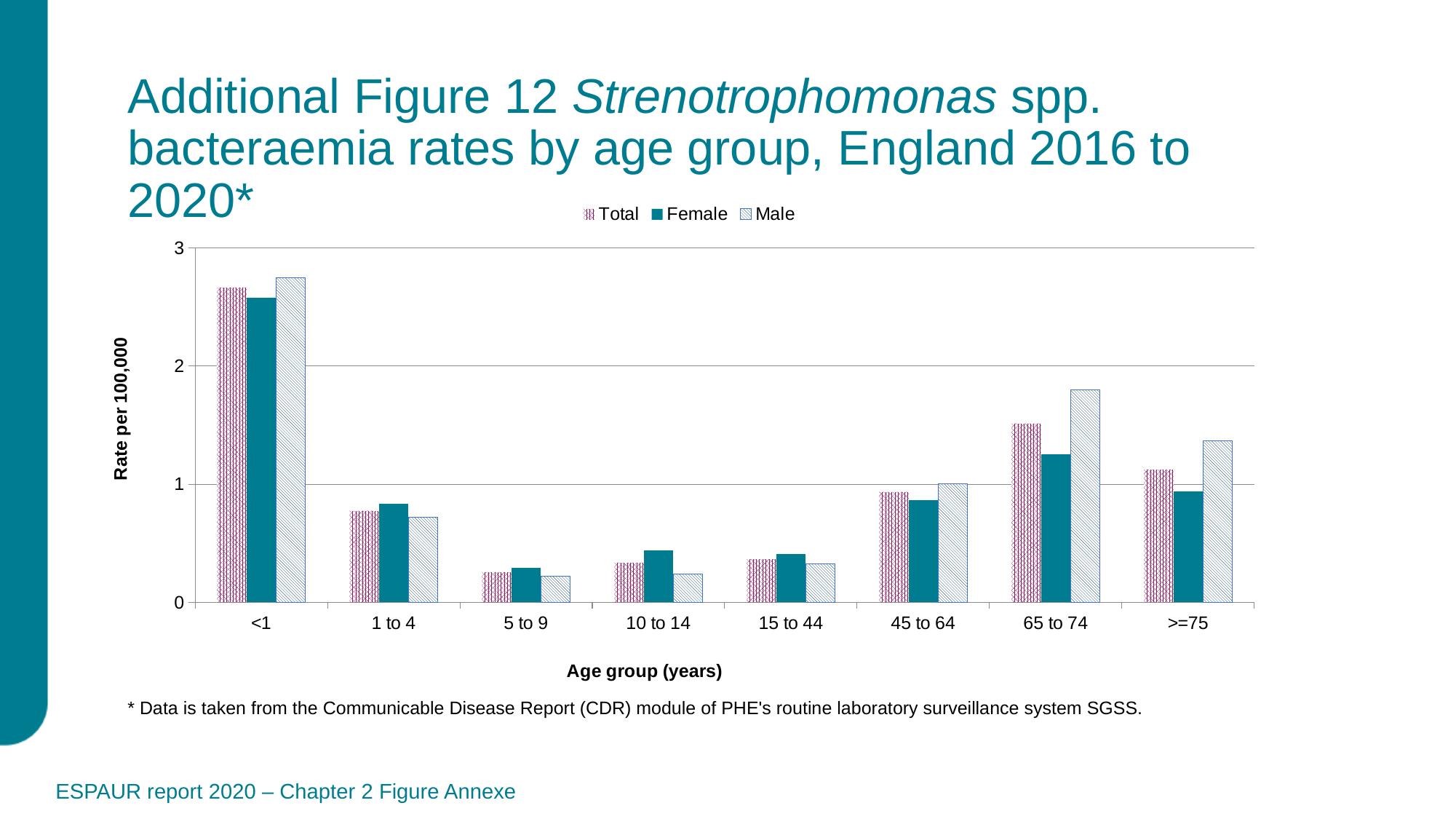
For the 65 to 74 age group, which is larger, the Male rate or the Female rate? Male How many age groups are shown on the x axis? 8 Is the Male rate for the 65 to 74 age group greater or less than 2? less Does the Total rate rise or fall from the 5 to 9 age group to the 65 to 74 age group? rise Which age group has the highest Male rate? <1 Is the Female rate for the 65 to 74 age group greater or less than 1? greater For the 10 to 14 age group, which is larger, the Female rate or the Male rate? Female Which age group has the lowest Total rate? 5 to 9 Is the Male rate for the <1 age group greater or less than 2? greater How many series does the legend list? 3 What kind of chart is shown on the slide? bar chart What is the title of the y axis? Rate per 100,000